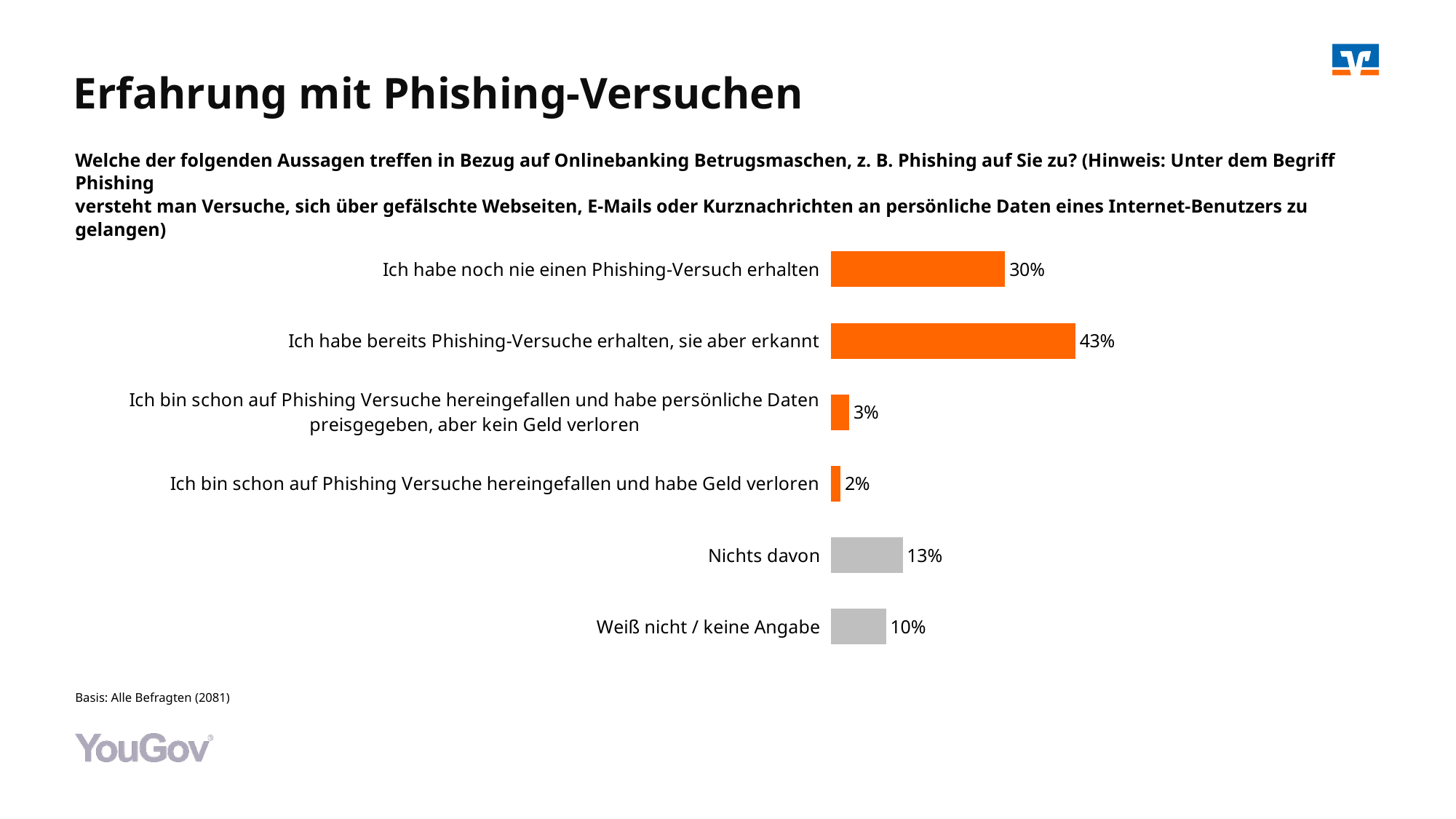
Which is larger: the value for "Nichts davon" or the value for "Weiß nicht / keine Angabe"? Nichts davon Which statement has the lowest percentage? Ich bin schon auf Phishing Versuche hereingefallen und habe Geld verloren What is the difference between the share who received phishing attempts but recognised them (43%) and the share who never received one (30%)? 13 percentage points What is the combined percentage of the two statements about having fallen for phishing attempts (3% and 2%)? 5% Which statement has the highest percentage? Ich habe bereits Phishing-Versuche erhalten, sie aber erkannt What colour are the bars for "Nichts davon" and "Weiß nicht / keine Angabe"? Grey What type of chart is shown on the slide? Bar chart What percentage of respondents said "Ich habe bereits Phishing-Versuche erhalten, sie aber erkannt"? 43% What percentage is shown for "Nichts davon"? 13% What is the value for "Weiß nicht / keine Angabe"? 10% What is the value for "Ich habe noch nie einen Phishing-Versuch erhalten"? 30% How many categories (statements) are shown in the chart? 6